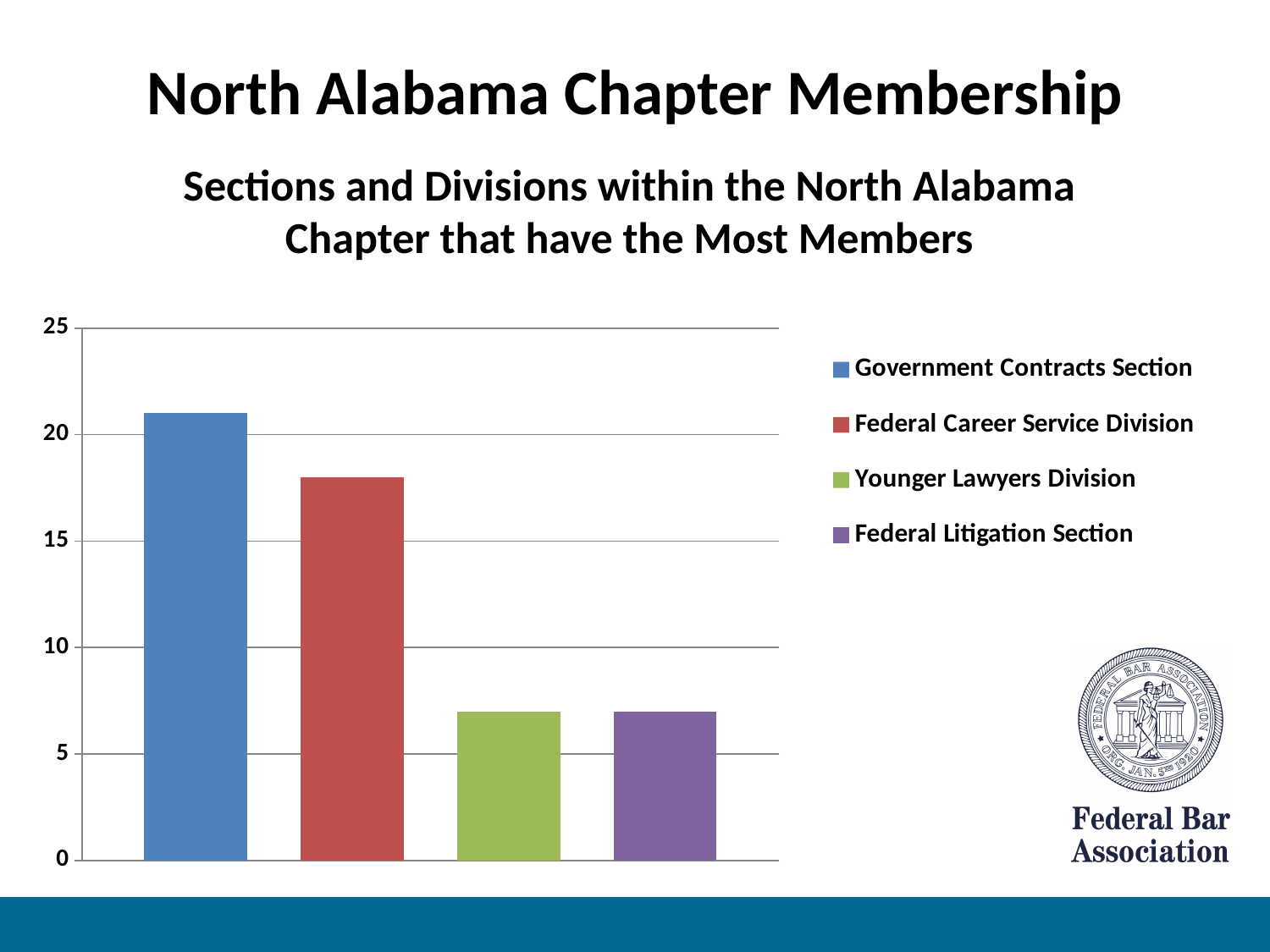
What colour is the bar for Younger Lawyers Division? green Is the value for Federal Litigation Section greater or less than 5? greater Is the value for Government Contracts Section greater or less than 20? greater Which is larger, the value for Federal Career Service Division or the value for Younger Lawyers Division? Federal Career Service Division Which is larger, the value for Government Contracts Section or the value for Federal Career Service Division? Government Contracts Section Which section or division has the highest number of members? Government Contracts Section Is the value for Federal Career Service Division greater or less than 15? greater How many series does the legend list? 4 How many bars are plotted in the chart? 4 What kind of chart is shown on the slide? bar chart